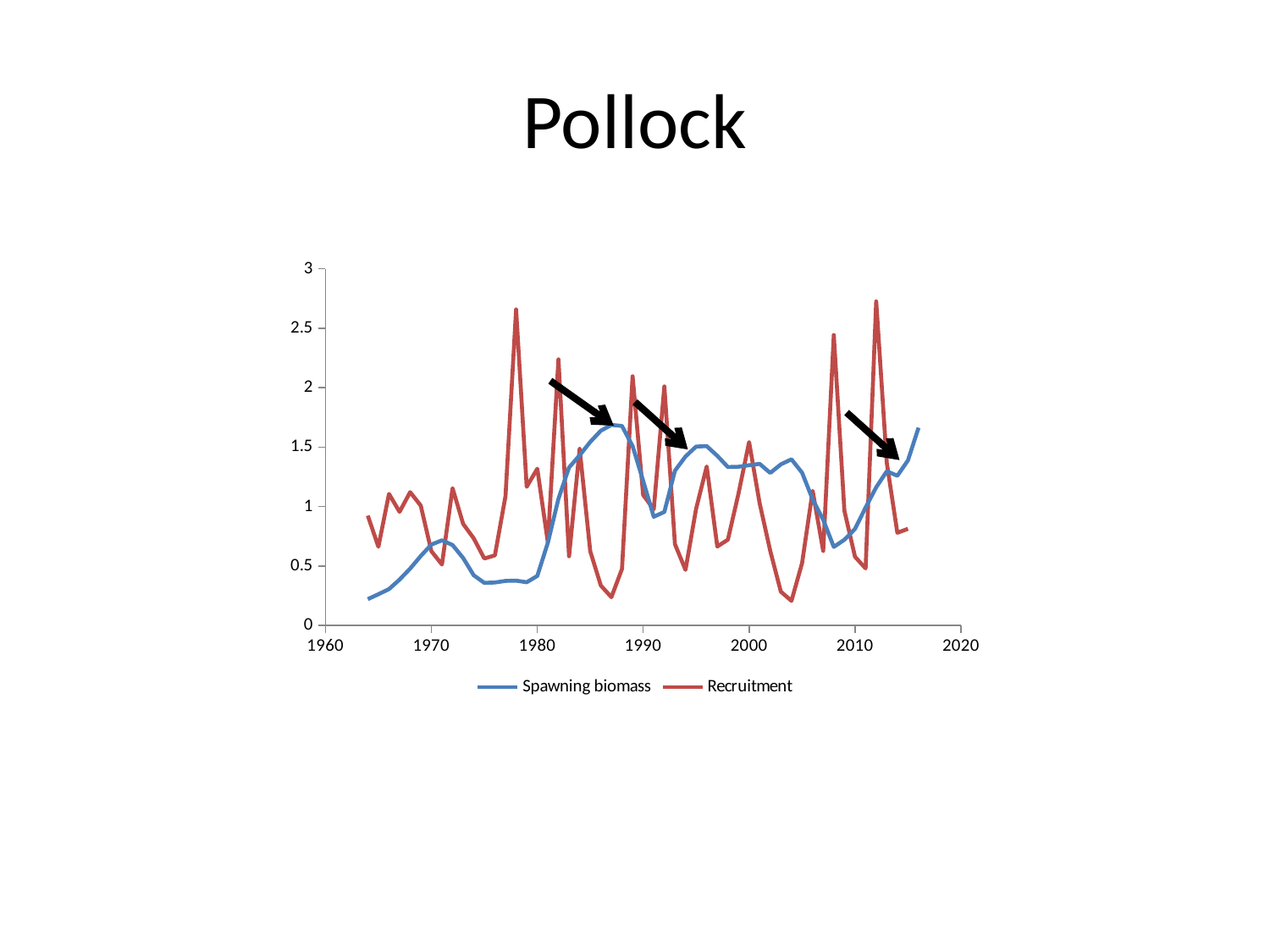
Is the Recruitment value around 2004 greater or less than 0.5? less What is the title of the slide's chart? Pollock Is the Spawning biomass value in 2016 greater or less than 1.5? greater Which series is drawn in red? Recruitment Around 1987, which series has the larger value, Spawning biomass or Recruitment? Spawning biomass Is the Recruitment value around 2012 greater or less than 2.5? greater Does the Spawning biomass line rise or fall between 1975 and 1987? rise What kind of chart is shown on the slide? line chart Which series reaches the highest value anywhere on the chart? Recruitment How many series does the legend list? 2